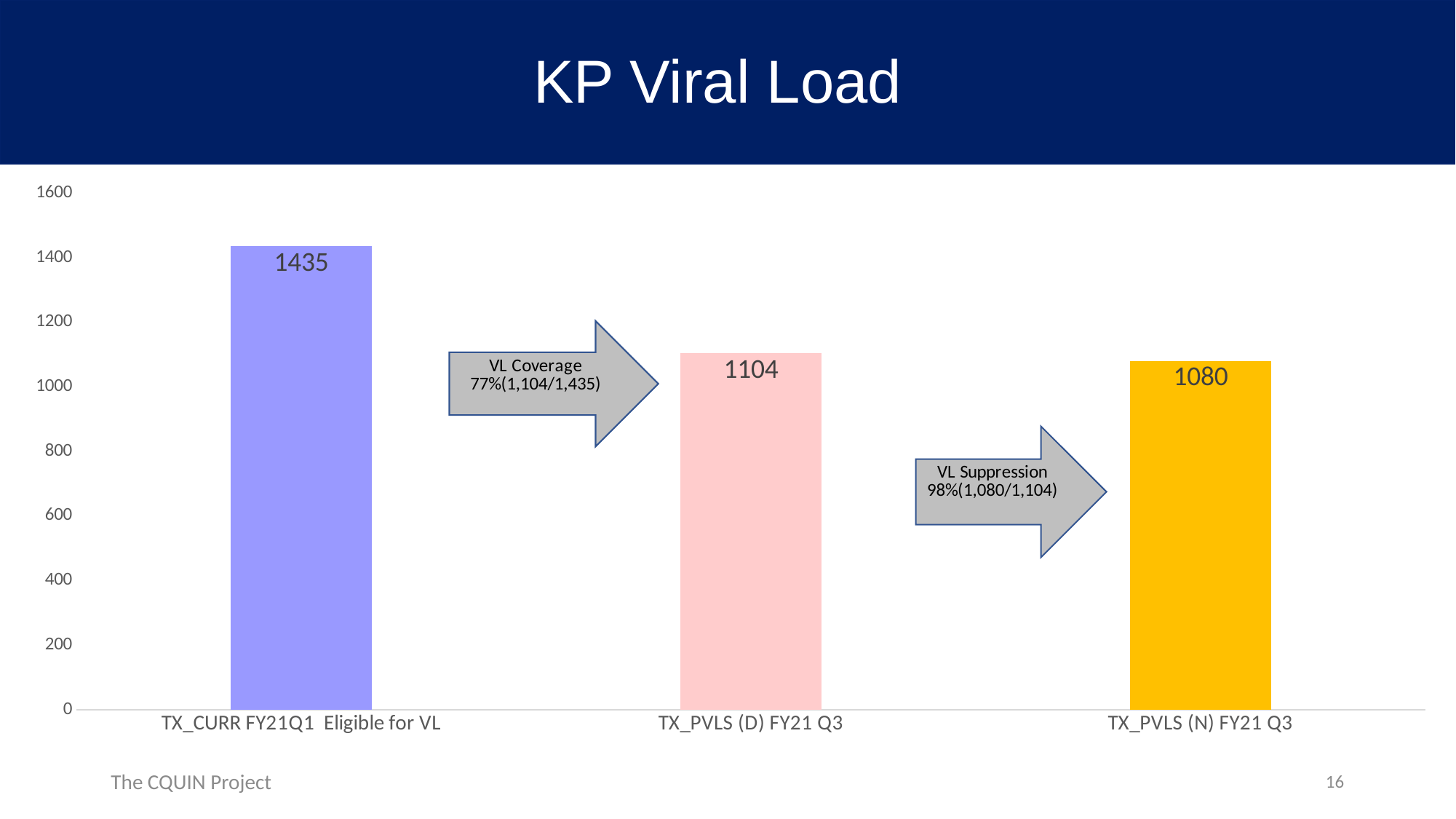
What is the difference between the values for TX_CURR FY21Q1 Eligible for VL and TX_PVLS (D) FY21 Q3? 331 What is the value for TX_CURR FY21Q1 Eligible for VL? 1435 What kind of chart is shown on the slide? Bar chart Which is larger, the value for TX_CURR FY21Q1 Eligible for VL or the value for TX_PVLS (N) FY21 Q3? TX_CURR FY21Q1 Eligible for VL What VL Coverage percentage is shown in the arrow between the first and second bars? 77% Do the values rise or fall from left to right across the categories? Fall How many categories are shown on the chart? 3 Which category has the lowest value? TX_PVLS (N) FY21 Q3 Which category has the highest value? TX_CURR FY21Q1 Eligible for VL What is the difference between the values for TX_PVLS (D) FY21 Q3 and TX_PVLS (N) FY21 Q3? 24 What is the value for TX_PVLS (D) FY21 Q3? 1104 What is the value for TX_PVLS (N) FY21 Q3? 1080